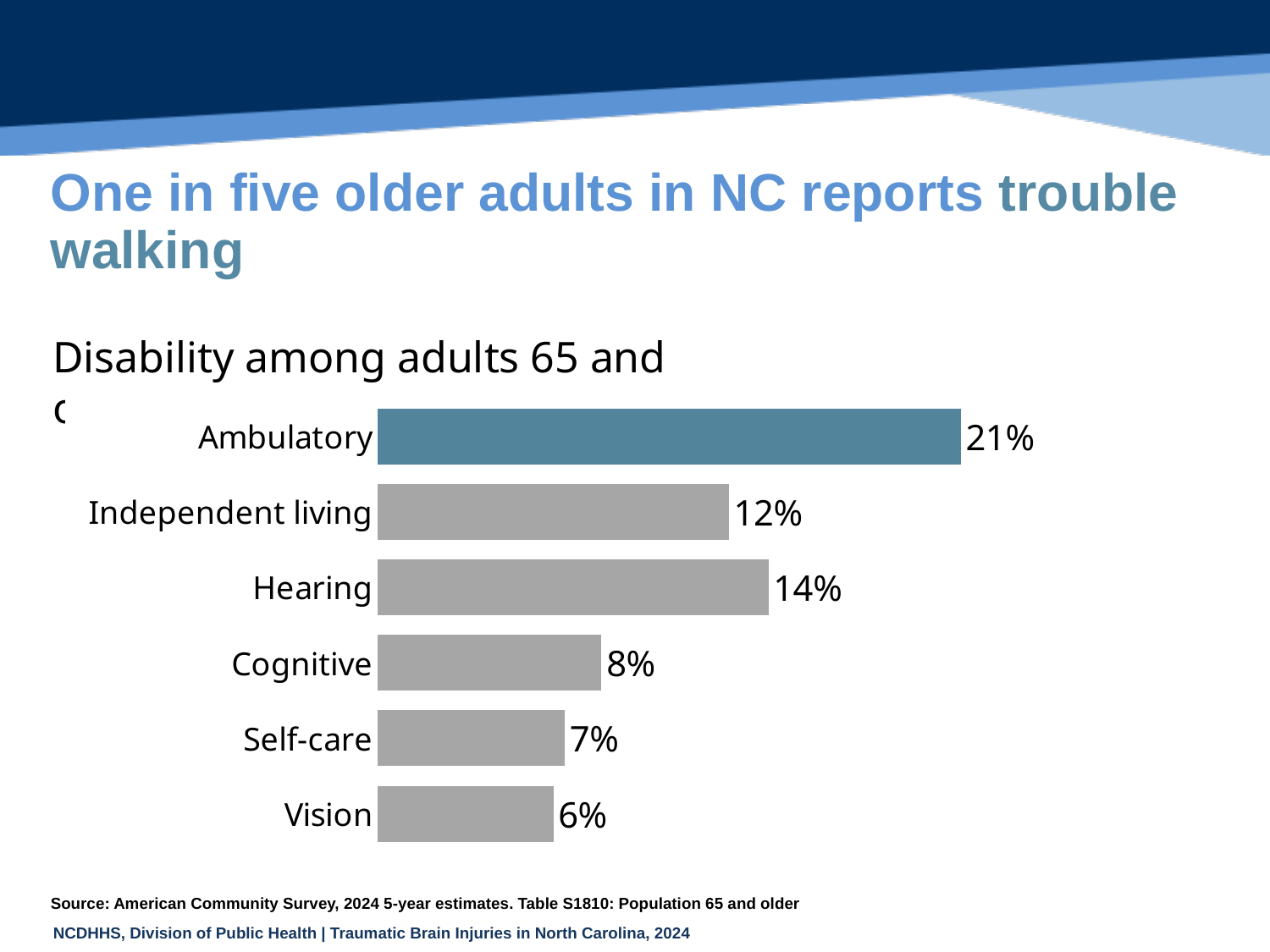
What is the value shown for Independent living? 12% What is the difference between the Cognitive and Self-care values? 1% What type of chart is shown on the slide? Bar chart Which is larger, the value for Hearing or the value for Independent living? Hearing What is the difference between the Ambulatory and Hearing values? 7% How many disability categories are shown in the chart? 6 What is the value shown for Vision? 6% Which bar is highlighted in a different colour from the others? Ambulatory What is the value shown for Hearing? 14% Which disability category has the highest value? Ambulatory What percentage of adults 65 and older report an ambulatory disability? 21% Which disability category has the lowest value? Vision